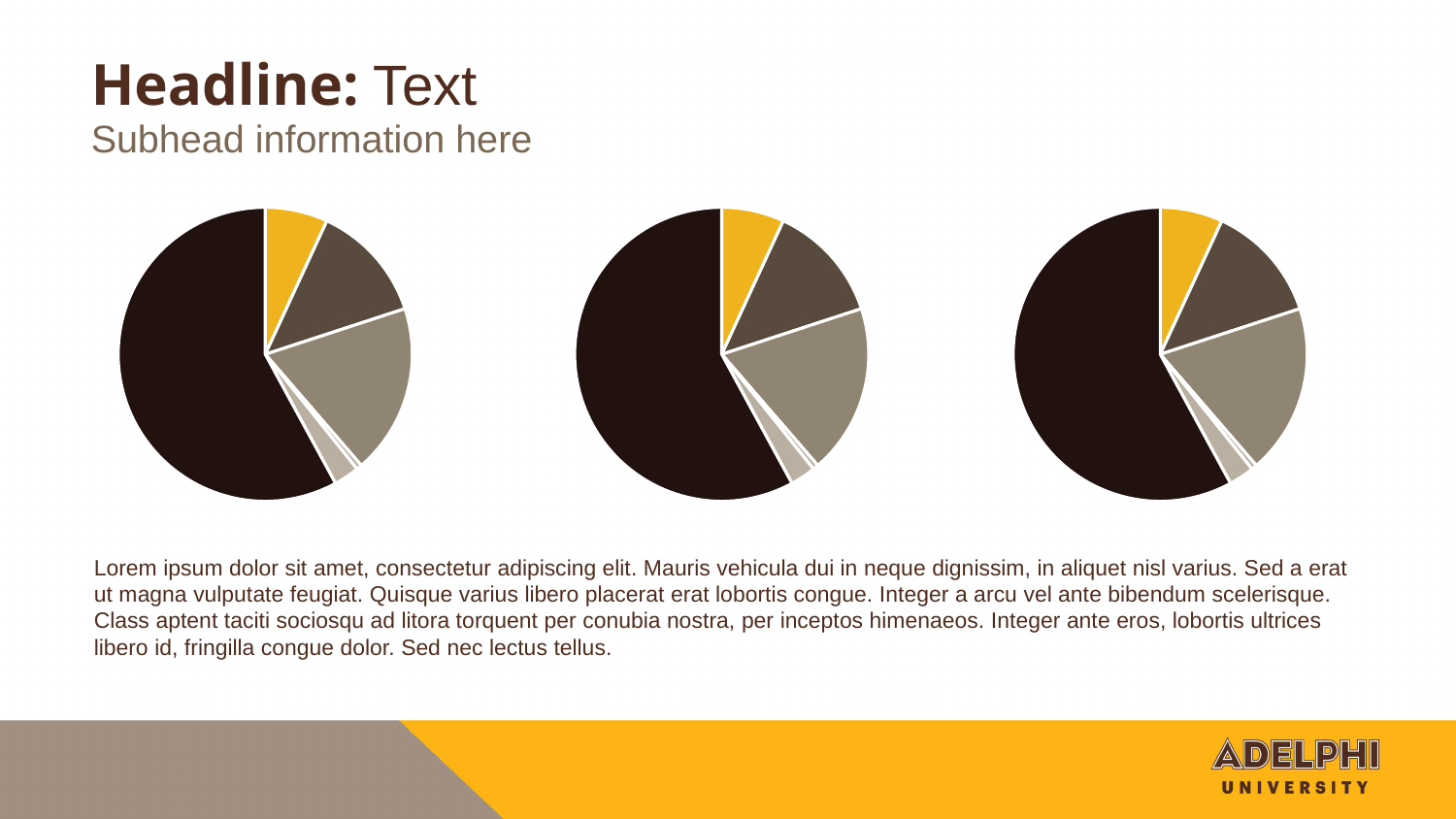
Do the pie charts on the slide show data labels? No In the middle pie chart, which colour slice is the largest? The dark brown slice How many pie charts are on the slide? 3 In the right pie chart, which colour slice is the largest? The dark brown slice In the left pie chart, which is larger: the yellow slice or the dark brown slice? The dark brown slice In the left pie chart, which colour slice is the largest? The dark brown slice Does the largest slice in the middle pie chart take up more or less than half of the pie? More What kind of chart is shown on the left of the slide? Pie chart Do the pie charts on the slide have a legend? No